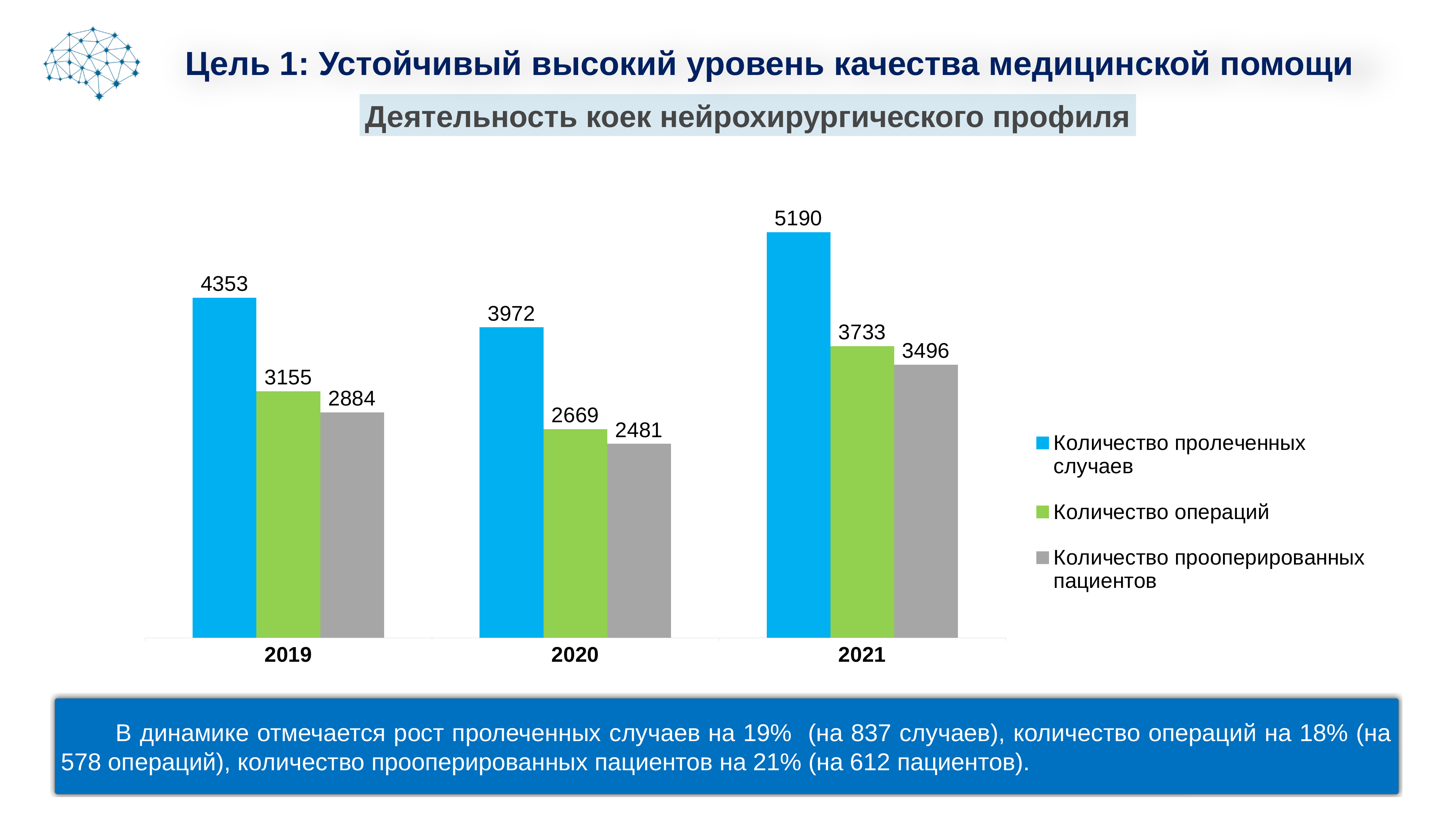
What is the value of "Количество пролеченных случаев" in 2021? 5190 What is the difference between "Количество пролеченных случаев" in 2021 and in 2019? 837 What is the difference between "Количество операций" and "Количество прооперированных пациентов" in 2021? 237 How many years are shown on the x axis? 3 What kind of chart is shown on the slide? bar chart In which year is "Количество операций" the lowest? 2020 In which year is "Количество пролеченных случаев" the highest? 2021 What is the value of "Количество операций" in 2020? 2669 Which is larger: "Количество прооперированных пациентов" in 2019 or in 2020? 2019 What is the value of "Количество прооперированных пациентов" in 2019? 2884 How many series does the legend list? 3 Which colour represents "Количество операций" in the chart? green